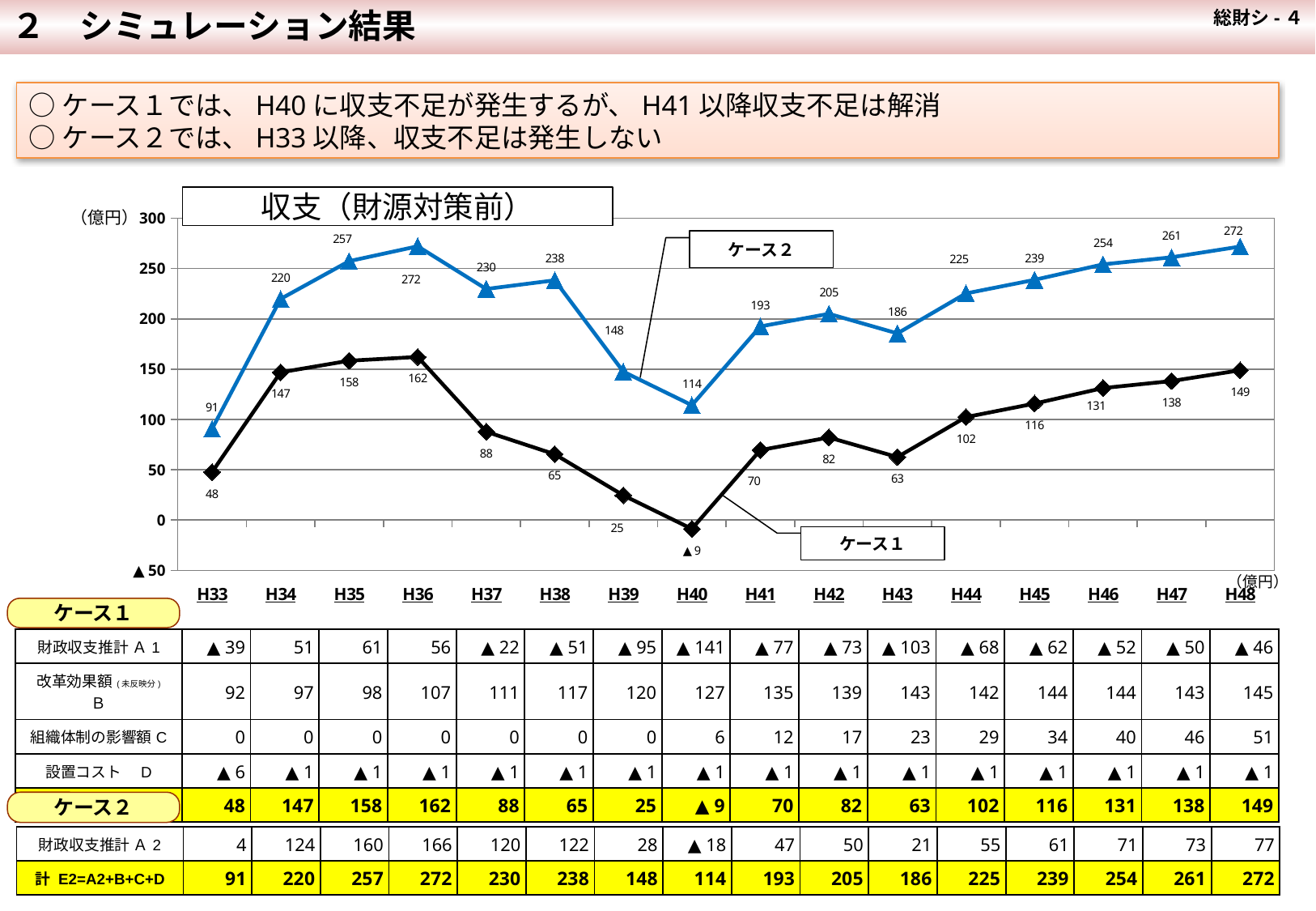
What is the value for ケース1 at H36? 162 What is the title of the chart? 収支（財源対策前） Which is larger, the value for ケース2 at H37 or at H38? H38 In which year does ケース2 have its lowest value? H33 How many series does the chart show? 2 What type of chart is shown on the slide? line chart In which year does ケース1 reach its highest value? H36 How many years are plotted along the x axis of the chart? 16 What is the difference between ケース2 and ケース1 at H48? 123 What is the value for ケース1 at H40? ▲ 9 Do the values for ケース1 rise or fall from H44 to H48? rise What is the value for ケース2 at H40? 114